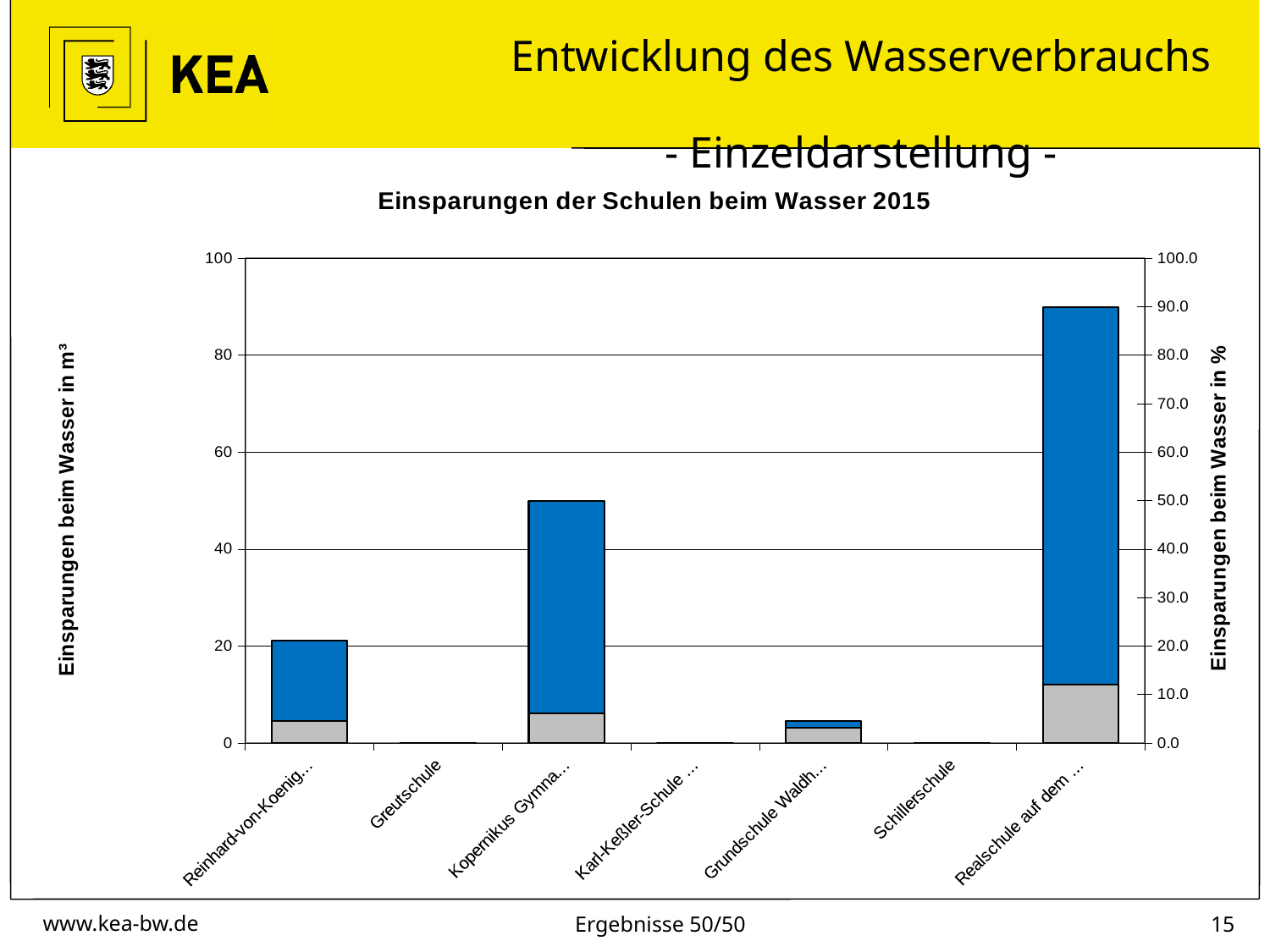
Is the blue bar for Realschule auf dem ... greater or less than 80 on the left axis? greater What kind of chart is shown on the slide? bar chart Is the blue bar for Reinhard-von-Koenig... greater or less than 40 on the left axis? less Is the blue bar for Kopernikus Gymna... greater or less than 40 on the left axis? greater What is the title of the chart? Einsparungen der Schulen beim Wasser 2015 Which has the taller blue bar, Realschule auf dem ... or Kopernikus Gymna...? Realschule auf dem ... How many schools (categories) are shown on the x axis of the chart? 7 Which school has the highest bar in the chart? Realschule auf dem ... What is the label of the left vertical axis of the chart? Einsparungen beim Wasser in m³ Which has the taller blue bar, Kopernikus Gymna... or Reinhard-von-Koenig...? Kopernikus Gymna...